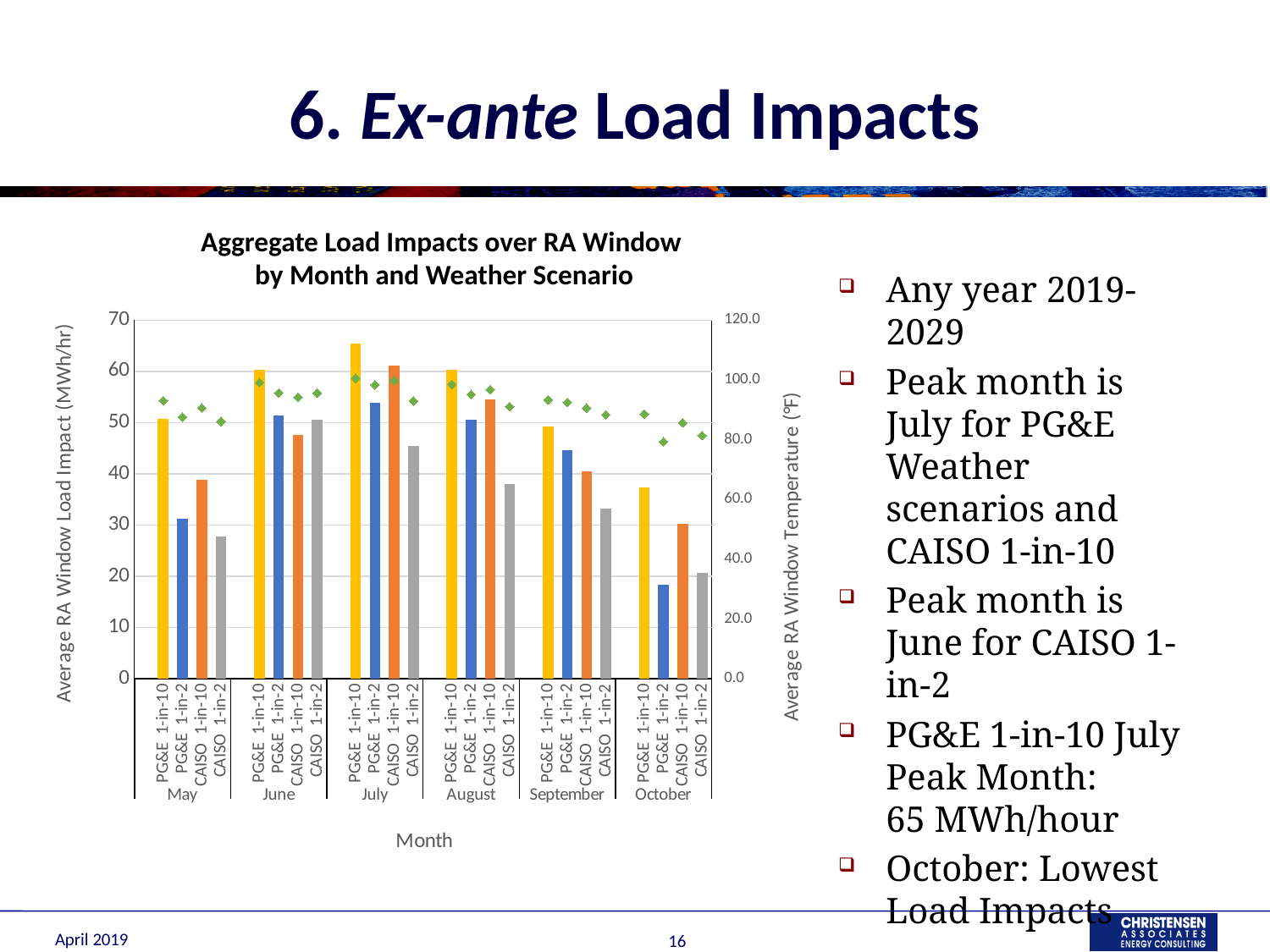
How many bars are plotted for each month in the chart? 4 In which month is the PG&E 1-in-10 bar the lowest? October In which month is the PG&E 1-in-10 bar the highest? July Is the value for PG&E 1-in-10 in July greater or less than 60? greater What is the title of the chart? Aggregate Load Impacts over RA Window by Month and Weather Scenario In which month is the CAISO 1-in-2 bar the highest? June In June, which is larger: the PG&E 1-in-10 bar or the PG&E 1-in-2 bar? PG&E 1-in-10 What type of chart is used to show the load impacts? bar chart Do the PG&E 1-in-10 bars rise or fall from July through October? fall How many months are shown on the x axis of the chart? 6 Is the value for PG&E 1-in-2 in October greater or less than 20? less Is the value for CAISO 1-in-2 in September greater or less than 40? less